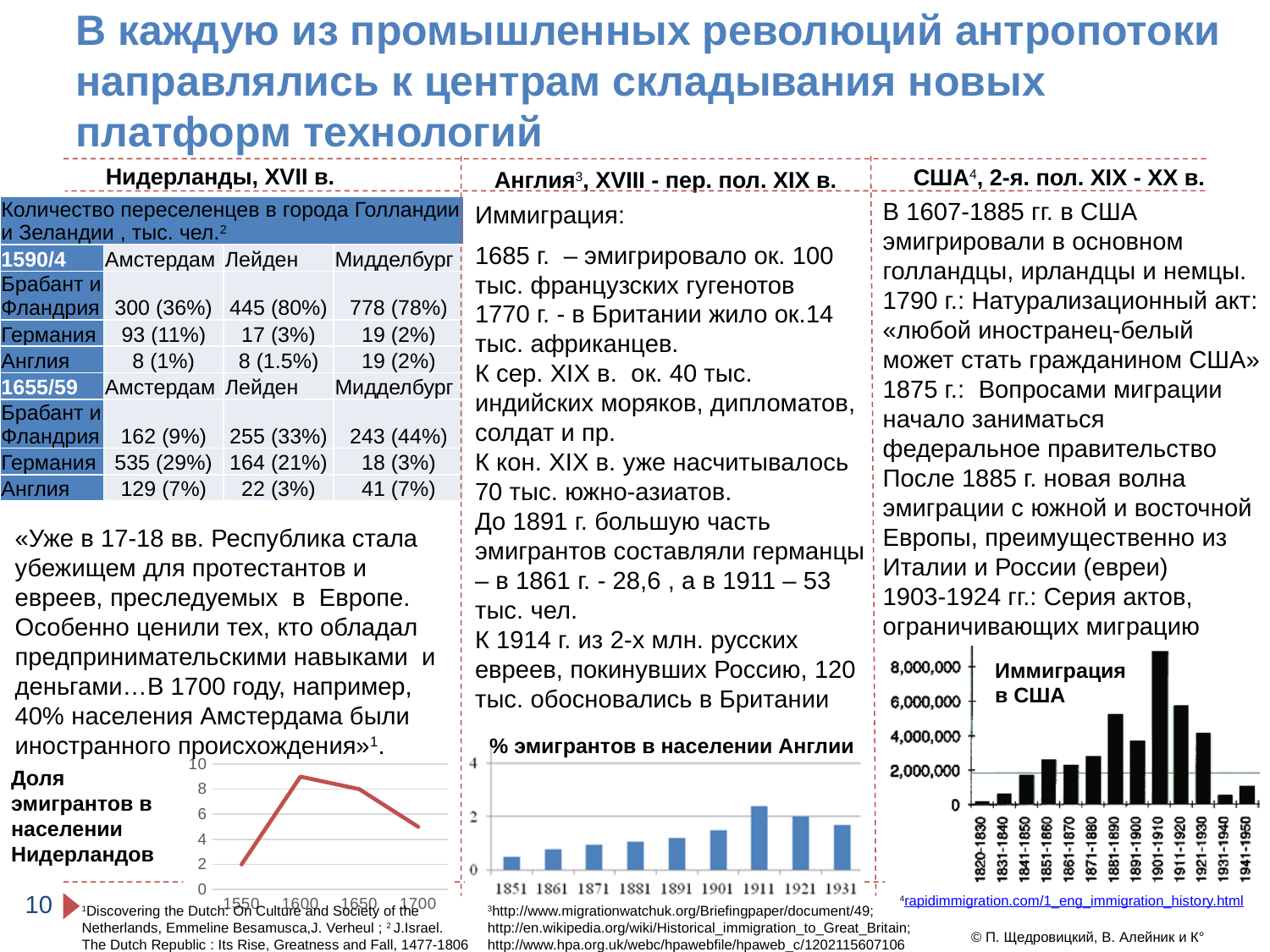
In the 'Иммиграция в США' chart, is the value for 1881-1890 greater or less than 4,000,000? greater In the 'Доля эмигрантов в населении Нидерландов' chart, does the value rise or fall between 1650 and 1700? fall What kind of chart is the 'Доля эмигрантов в населении Нидерландов' chart at the bottom left? line chart In the 'Иммиграция в США' chart, which decade has the highest value? 1901-1910 How many years are shown on the x axis of the '% эмигрантов в населении Англии' chart? 9 In the '% эмигрантов в населении Англии' chart, is the value for 1911 greater or less than 2? greater In the 'Иммиграция в США' chart, which is larger: the value for 1911-1920 or for 1921-1930? 1911-1920 In the 'Доля эмигрантов в населении Нидерландов' chart, which year has the lowest value? 1550 In the '% эмигрантов в населении Англии' chart, which year has the highest value? 1911 In the 'Доля эмигрантов в населении Нидерландов' chart, is the value for 1550 greater or less than 4? less In the 'Доля эмигрантов в населении Нидерландов' chart, which year has the highest value? 1600 What kind of chart is the '% эмигрантов в населении Англии' chart? bar chart